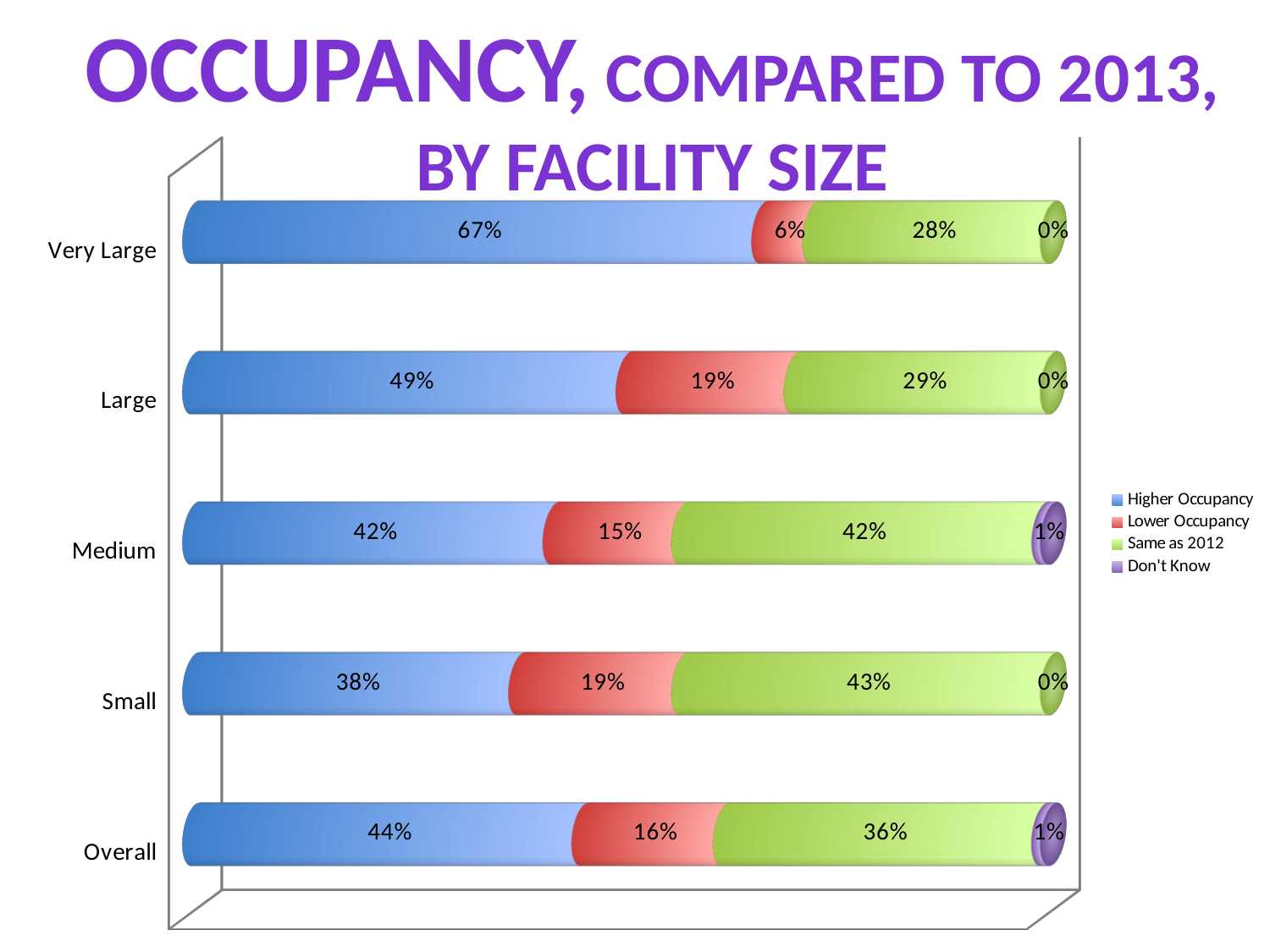
Which is larger for Medium facilities: Higher Occupancy or Lower Occupancy? Higher Occupancy Which facility size has the lowest Lower Occupancy value? Very Large What is the Lower Occupancy value for Large facilities? 19% How many facility size categories are shown on the chart? 5 What is the Don't Know value for Medium facilities? 1% How many series does the legend list? 4 Which facility size has the highest Higher Occupancy value? Very Large What is the difference between the Higher Occupancy values for Very Large and Small facilities? 29% What is the Same as 2012 value for Small facilities? 43% Which legend entry is shown in green? Same as 2012 What is the Higher Occupancy value for Very Large facilities? 67% What kind of chart is shown on the slide? Stacked bar chart